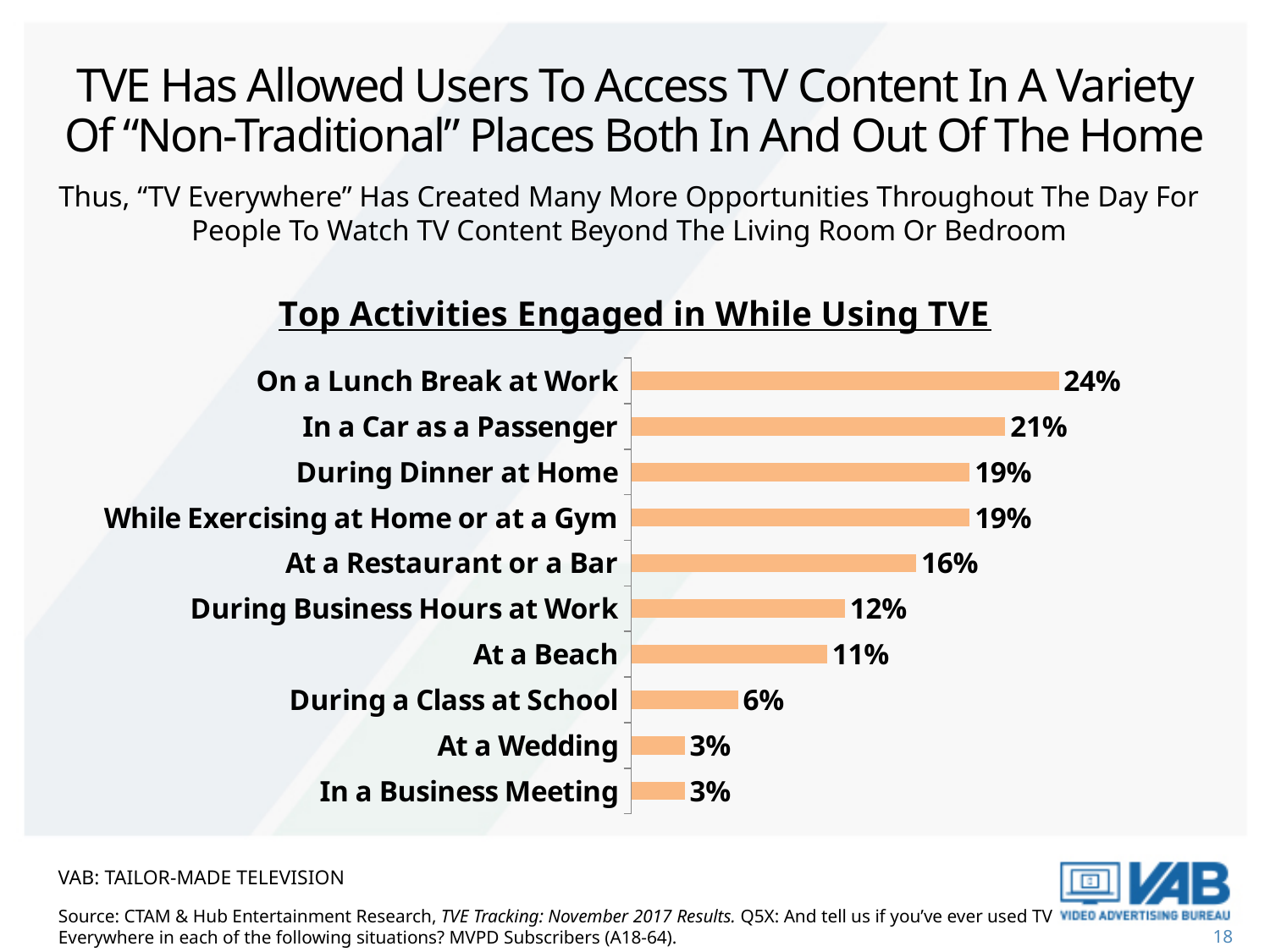
What kind of chart is shown on the slide? Bar chart What is the title of the chart? Top Activities Engaged in While Using TVE What is the difference between "In a Car as a Passenger" and "At a Beach"? 10% What is the value for "In a Business Meeting"? 3% How many activities are shown in the chart? 10 What is the difference between "On a Lunch Break at Work" and "During Business Hours at Work"? 12% What is the value for "At a Restaurant or a Bar"? 16% What is the value for "On a Lunch Break at Work"? 24% What is the value for "During a Class at School"? 6% Which activity has the highest value? On a Lunch Break at Work Which is larger, the value for "During Dinner at Home" or the value for "At a Beach"? During Dinner at Home Which is larger, the value for "At a Wedding" or the value for "During a Class at School"? During a Class at School